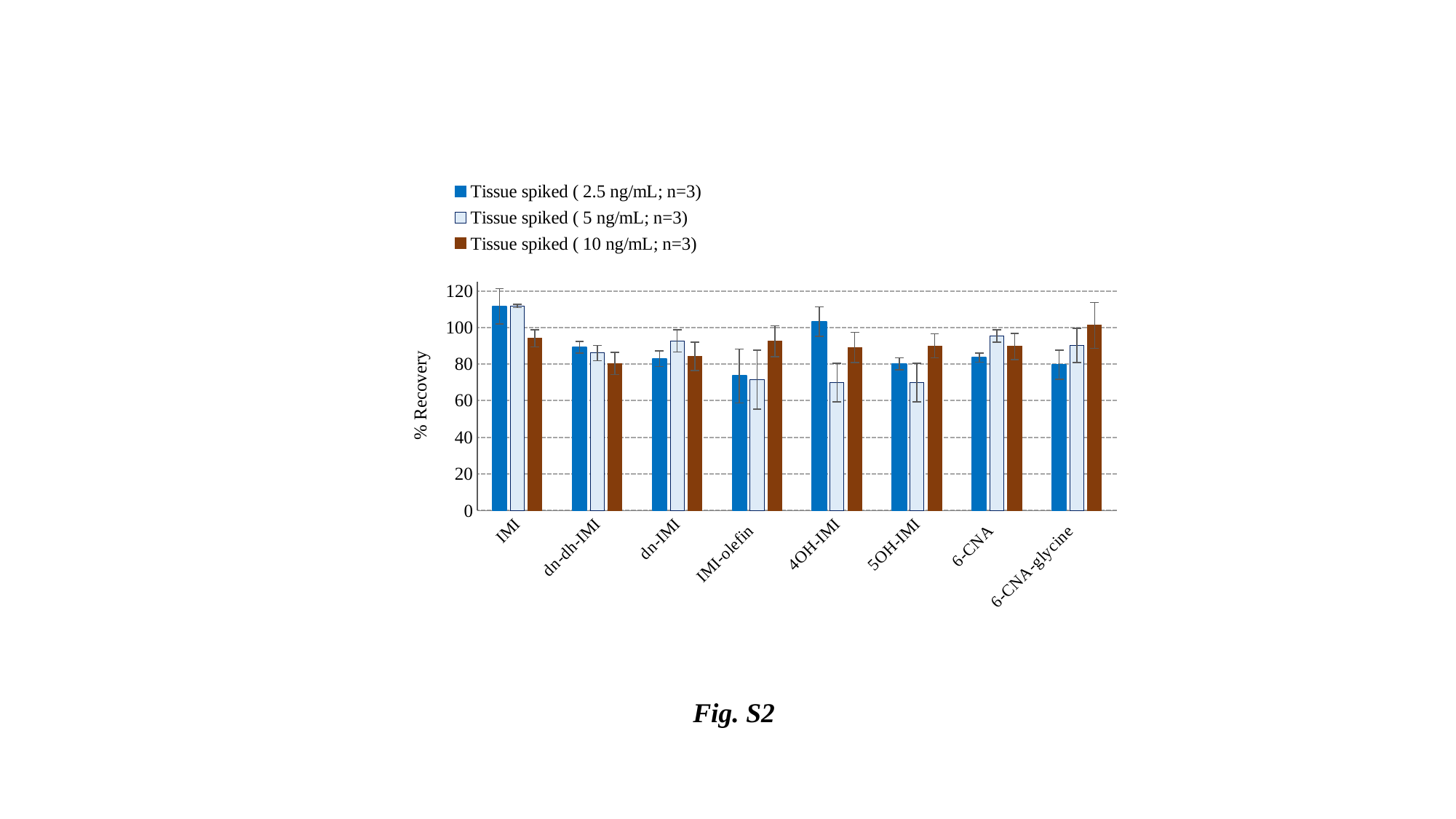
Is the value for IMI-olefin in the Tissue spiked (5 ng/mL; n=3) series greater or less than 80? less Is the value for IMI in the Tissue spiked (2.5 ng/mL; n=3) series greater or less than 100? greater What kind of chart is shown on the slide? bar chart How many series does the legend list? 3 Which category has the highest value in the Tissue spiked (5 ng/mL; n=3) series? IMI What is the label of the y axis? % Recovery Is the value for 5OH-IMI in the Tissue spiked (5 ng/mL; n=3) series greater or less than 80? less Which category has the highest value in the Tissue spiked (2.5 ng/mL; n=3) series? IMI What is the figure caption below the chart? Fig. S2 How many compound categories are shown on the x axis? 8 For 4OH-IMI, which is larger: the Tissue spiked (2.5 ng/mL; n=3) value or the Tissue spiked (5 ng/mL; n=3) value? Tissue spiked (2.5 ng/mL; n=3)